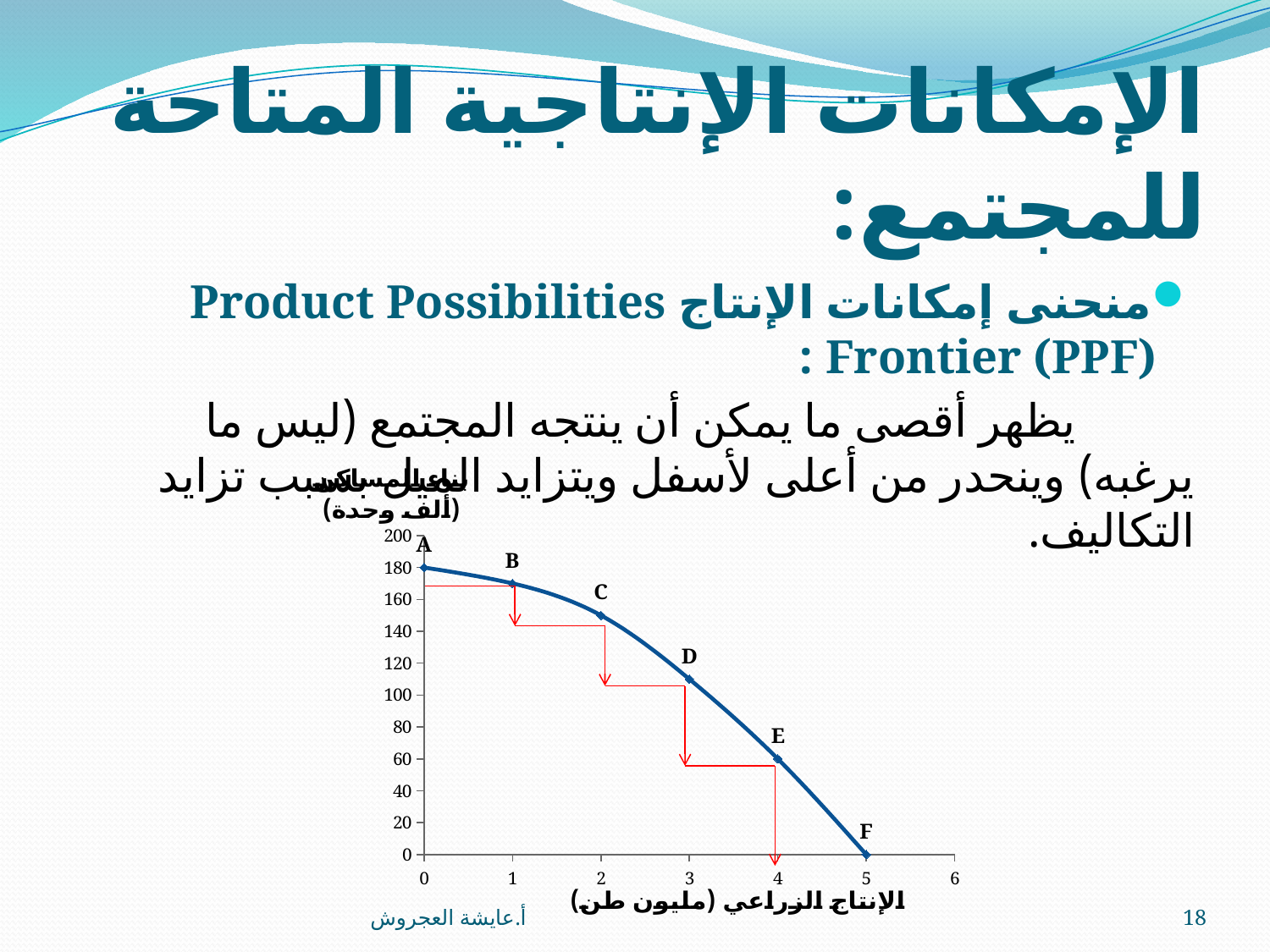
What kind of chart is shown on the slide? line chart Is the vertical-axis value at point B greater or less than 160? greater Is the vertical-axis value at point E greater or less than 80? less What is the horizontal-axis value at point D? 3 How many labeled points (A to F) are marked on the curve? 6 What is the horizontal-axis value at point F? 5 Which labeled point has the lowest vertical-axis value? F What is the vertical-axis value at point A? 180 Do the values on the curve rise or fall as the horizontal-axis value increases? fall Which point has the larger vertical-axis value, C or D? C Which labeled point has the highest vertical-axis value? A What is the vertical-axis value at point F? 0